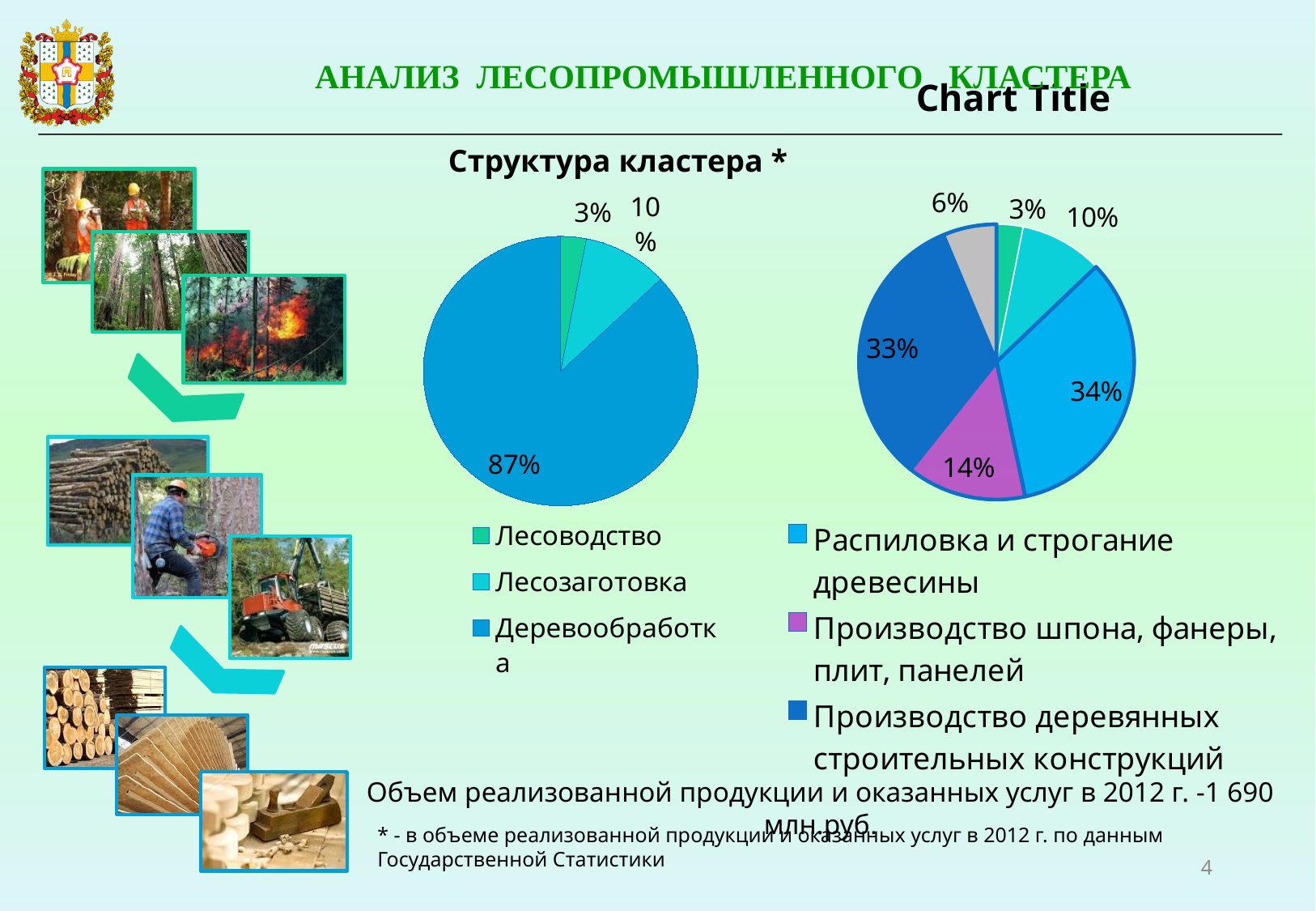
In the left pie chart "Структура кластера *", what share does Лесозаготовка have? 10% In the right pie chart titled "Chart Title", what share does Распиловка и строгание древесины have? 34% In the left pie chart "Структура кластера *", which category has the largest share? Деревообработка In the right pie chart titled "Chart Title", how many slices does the pie have? 6 In the left pie chart "Структура кластера *", what share does Лесоводство have? 3% In the right pie chart titled "Chart Title", what share does Производство деревянных строительных конструкций have? 33% In the left pie chart "Структура кластера *", how many entries does the legend list? 3 In the left pie chart "Структура кластера *", which category has the smallest share? Лесоводство In the right pie chart titled "Chart Title", what share does Производство шпона, фанеры, плит, панелей have? 14% What kind of chart is the left chart titled "Структура кластера *"? pie chart In the left pie chart "Структура кластера *", what share does Деревообработка have? 87% In the left pie chart "Структура кластера *", what is the difference between the shares of Деревообработка and Лесозаготовка? 77 percentage points